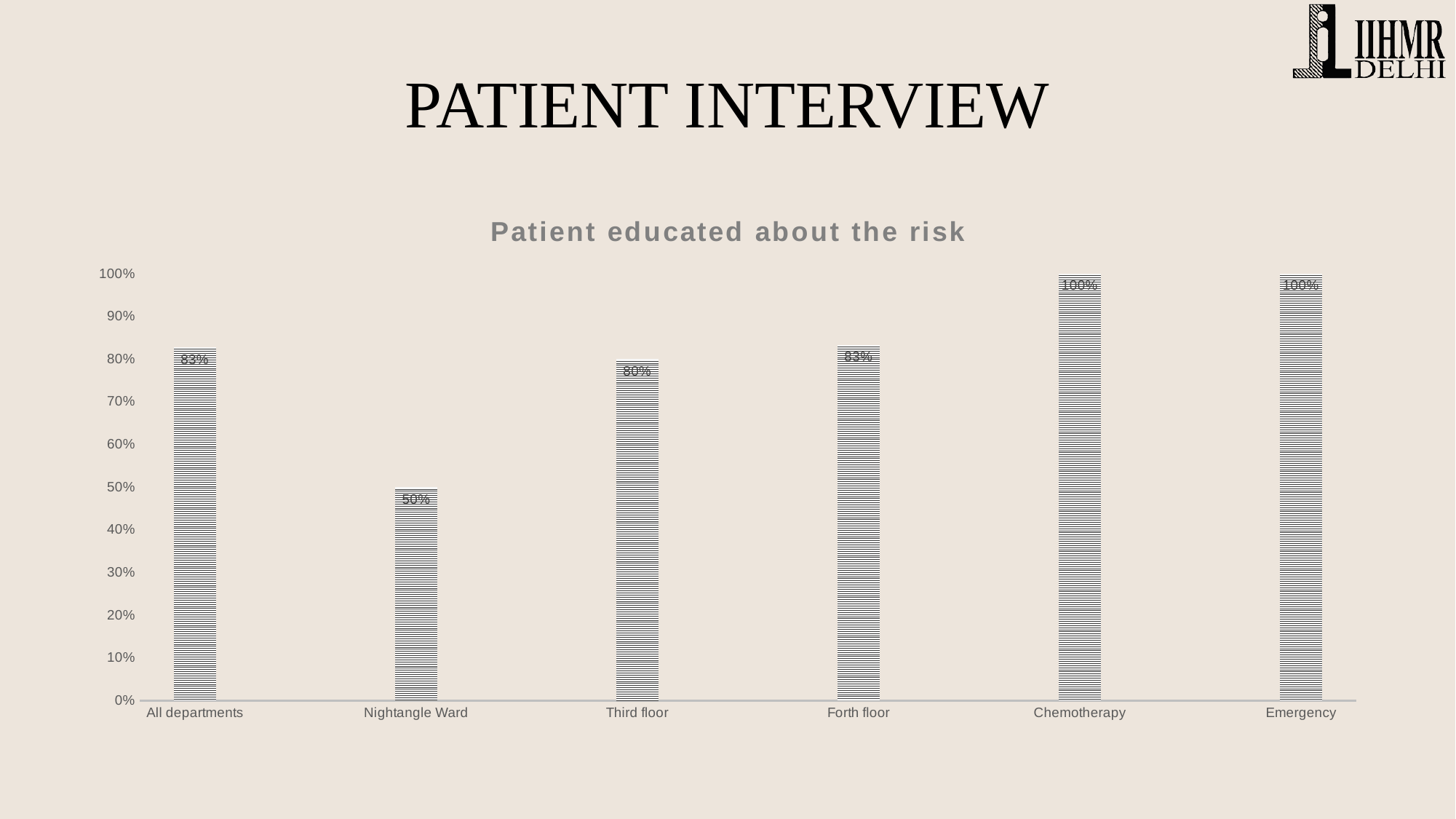
What is the value for Nightangle Ward? 50% How many categories are shown on the x axis? 6 Which category has the lowest value? Nightangle Ward What kind of chart is shown on the slide? bar chart What is the title of the chart? Patient educated about the risk Is the value for Forth floor greater or less than 70%? greater What is the value for Chemotherapy? 100% Which is larger, the value for Third floor or the value for Nightangle Ward? Third floor What is the value for All departments? 83% What is the difference between the values for Emergency and Third floor? 20% What is the difference between the values for Forth floor and Nightangle Ward? 33% What is the value for Third floor? 80%